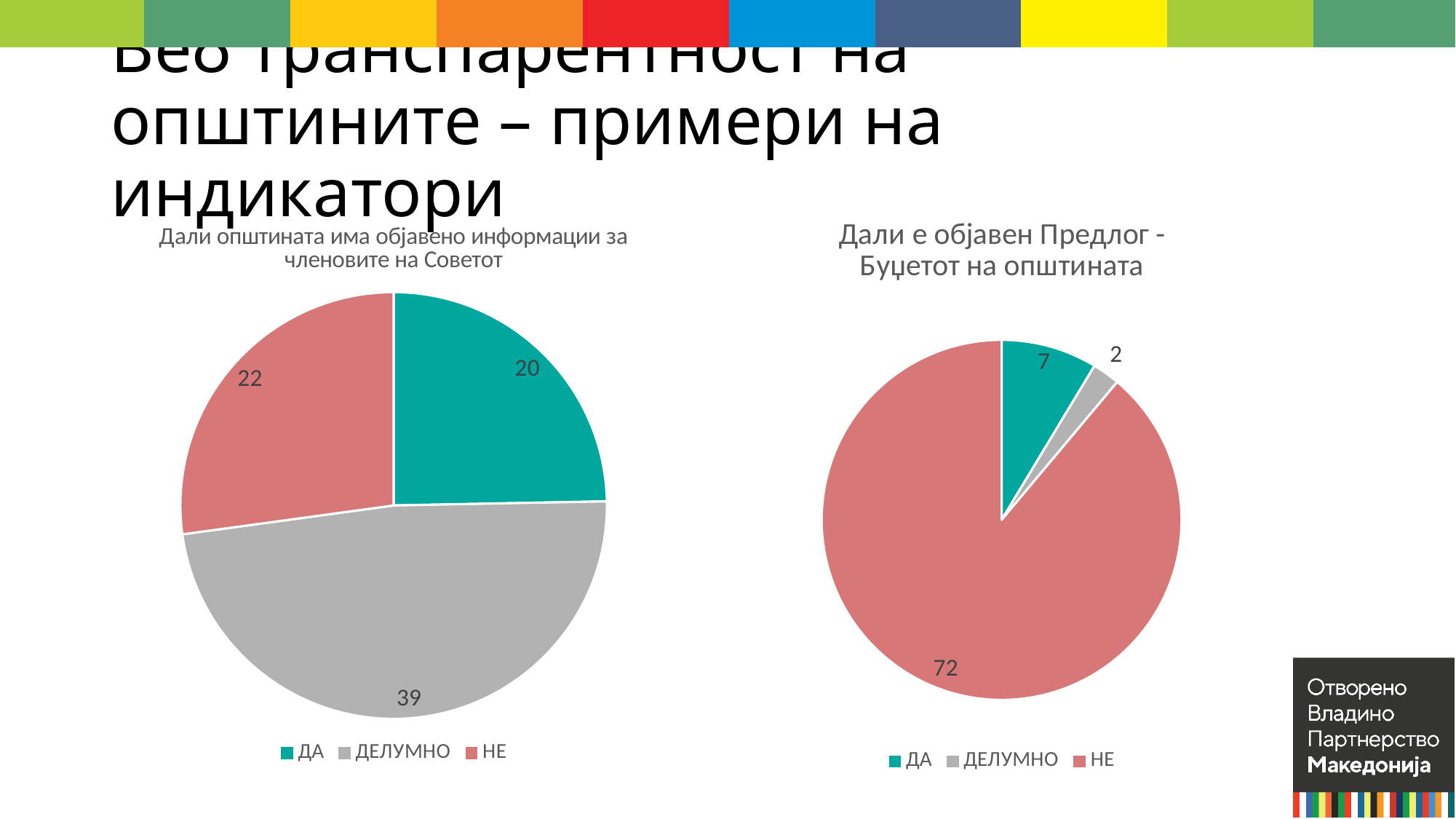
In the right chart (Дали е објавен Предлог - Буџетот на општината), what is the value for ДЕЛУМНО? 2 In the left chart (Дали општината има објавено информации за членовите на Советот), which colour represents ДА? Teal In the left chart (Дали општината има објавено информации за членовите на Советот), which is larger, the value for НЕ or the value for ДА? НЕ In the right chart (Дали е објавен Предлог - Буџетот на општината), what is the value for НЕ? 72 In the right chart (Дали е објавен Предлог - Буџетот на општината), what is the difference between the values for НЕ and ДА? 65 In the right chart (Дали е објавен Предлог - Буџетот на општината), which category has the smallest slice? ДЕЛУМНО In the left chart (Дали општината има објавено информации за членовите на Советот), what is the value for ДЕЛУМНО? 39 How many slices does the right chart (Дали е објавен Предлог - Буџетот на општината) have? 3 In the left chart (Дали општината има објавено информации за членовите на Советот), which category has the largest slice? ДЕЛУМНО What type of chart is the left chart (Дали општината има објавено информации за членовите на Советот)? Pie chart In the left chart (Дали општината има објавено информации за членовите на Советот), what is the value for ДА? 20 In the left chart (Дали општината има објавено информации за членовите на Советот), what is the difference between the values for ДЕЛУМНО and ДА? 19